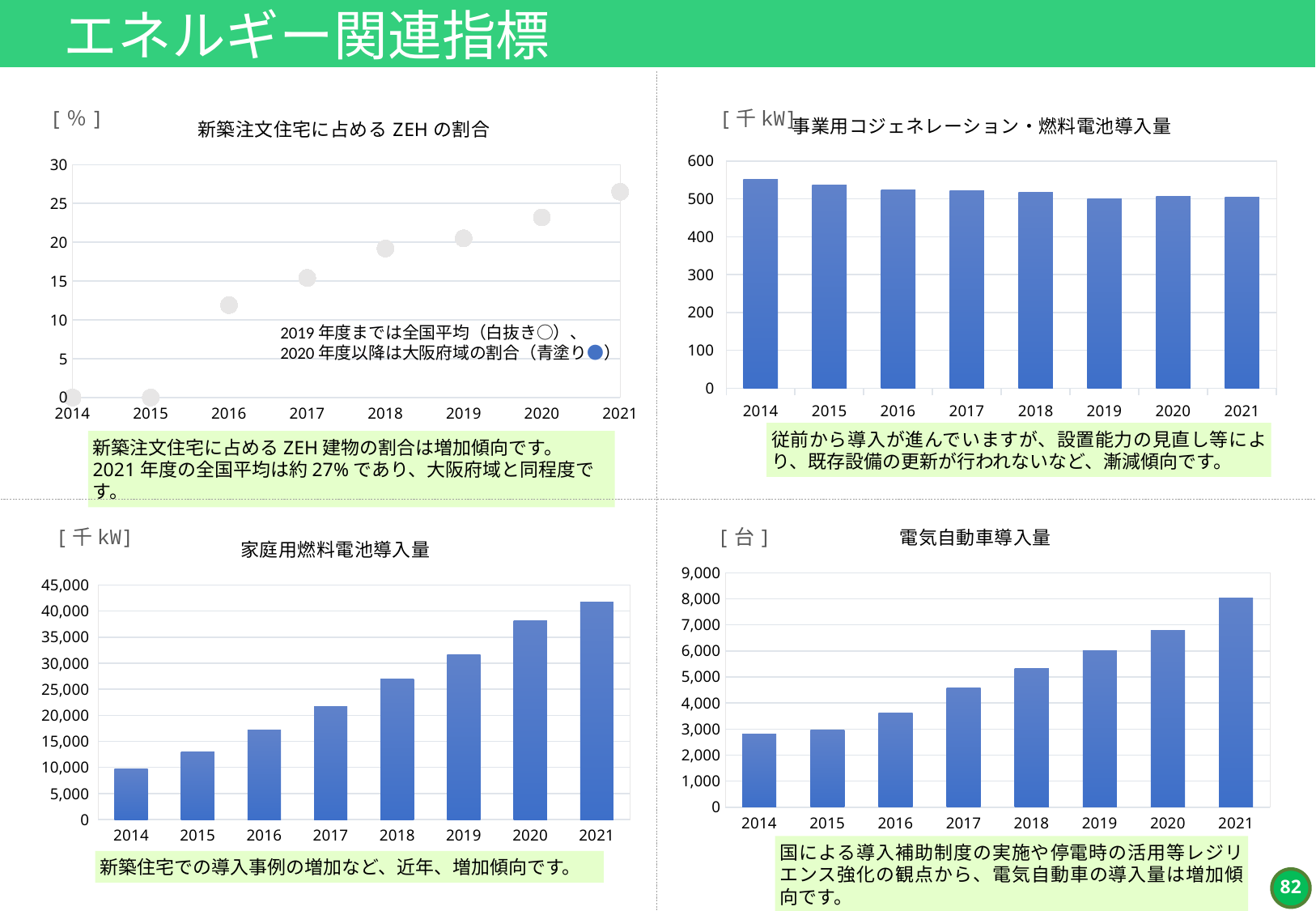
In the chart titled 新築注文住宅に占めるZEHの割合, which year has the highest value? 2021 In the chart titled 新築注文住宅に占めるZEHの割合, is the value for 2021 greater or less than 25? greater In the chart titled 電気自動車導入量, what unit is shown above the chart? 台 In the chart titled 家庭用燃料電池導入量, which is larger, the value for 2018 or the value for 2019? 2019 In the chart titled 新築注文住宅に占めるZEHの割合, do the values rise or fall from 2014 to 2021? rise In the chart titled 事業用コジェネレーション・燃料電池導入量, what kind of chart is shown? bar chart In the chart titled 事業用コジェネレーション・燃料電池導入量, is the value for 2014 greater or less than 500? greater In the chart titled 家庭用燃料電池導入量, which year has the lowest value? 2014 In the chart titled 事業用コジェネレーション・燃料電池導入量, which year has the highest value? 2014 In the chart titled 家庭用燃料電池導入量, is the value for 2021 greater or less than 40,000? greater In the chart titled 新築注文住宅に占めるZEHの割合, how many years are plotted on the x axis? 8